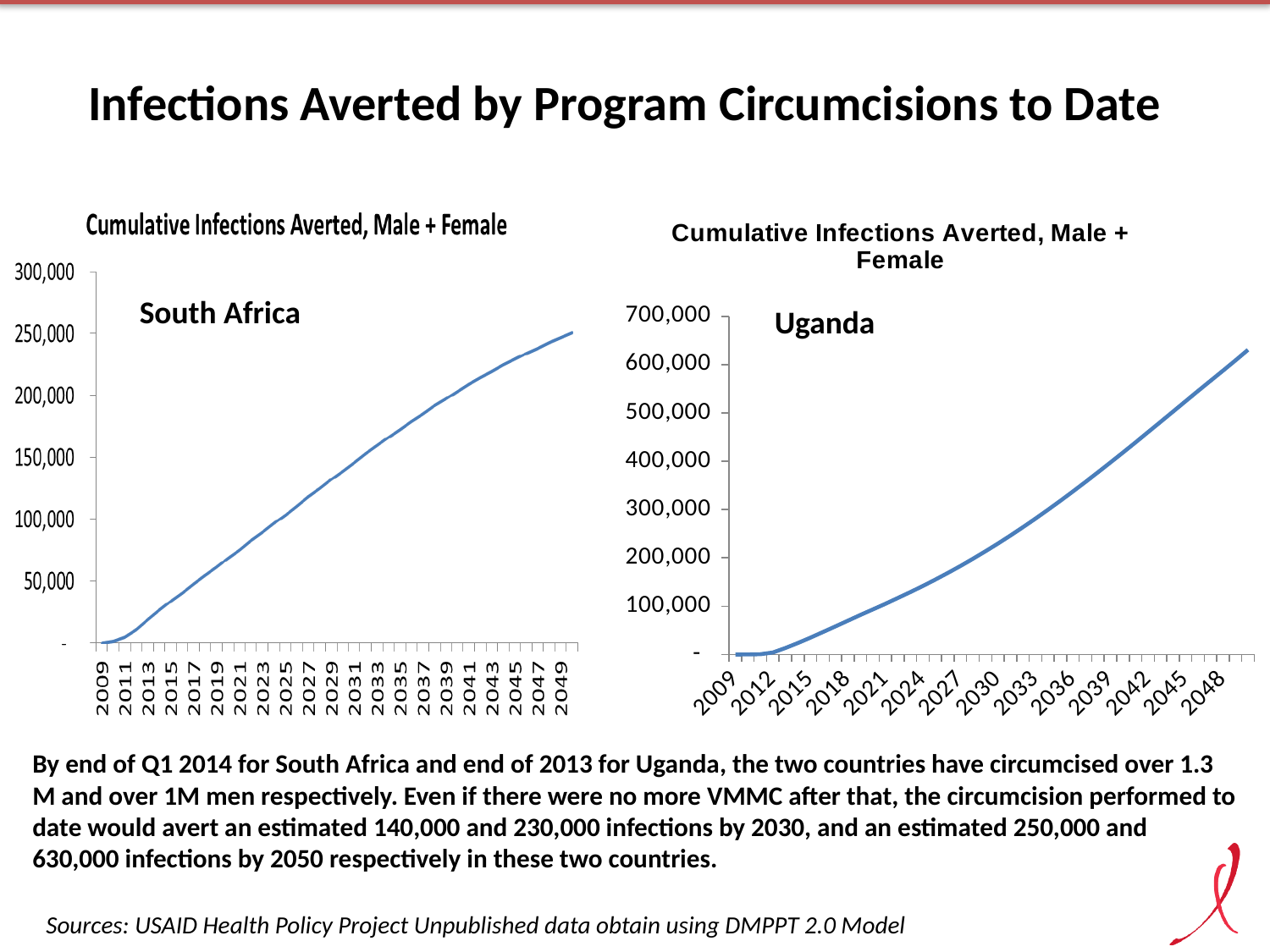
What kind of chart is the South Africa chart on the left? line chart In the South Africa chart, is the value for 2021 greater or less than 100,000? less In the South Africa chart, is the value for 2049 greater or less than 200,000? greater In the South Africa chart, is the value for 2030 greater or less than 100,000? greater What kind of chart is the Uganda chart on the right? line chart What is the title of the South Africa chart on the left? Cumulative Infections Averted, Male + Female In the Uganda chart, do the cumulative infections averted rise or fall over the years shown? rise In the South Africa chart, do the cumulative infections averted rise or fall from 2009 to 2049? rise What is the highest value shown on the y axis of the Uganda chart? 700,000